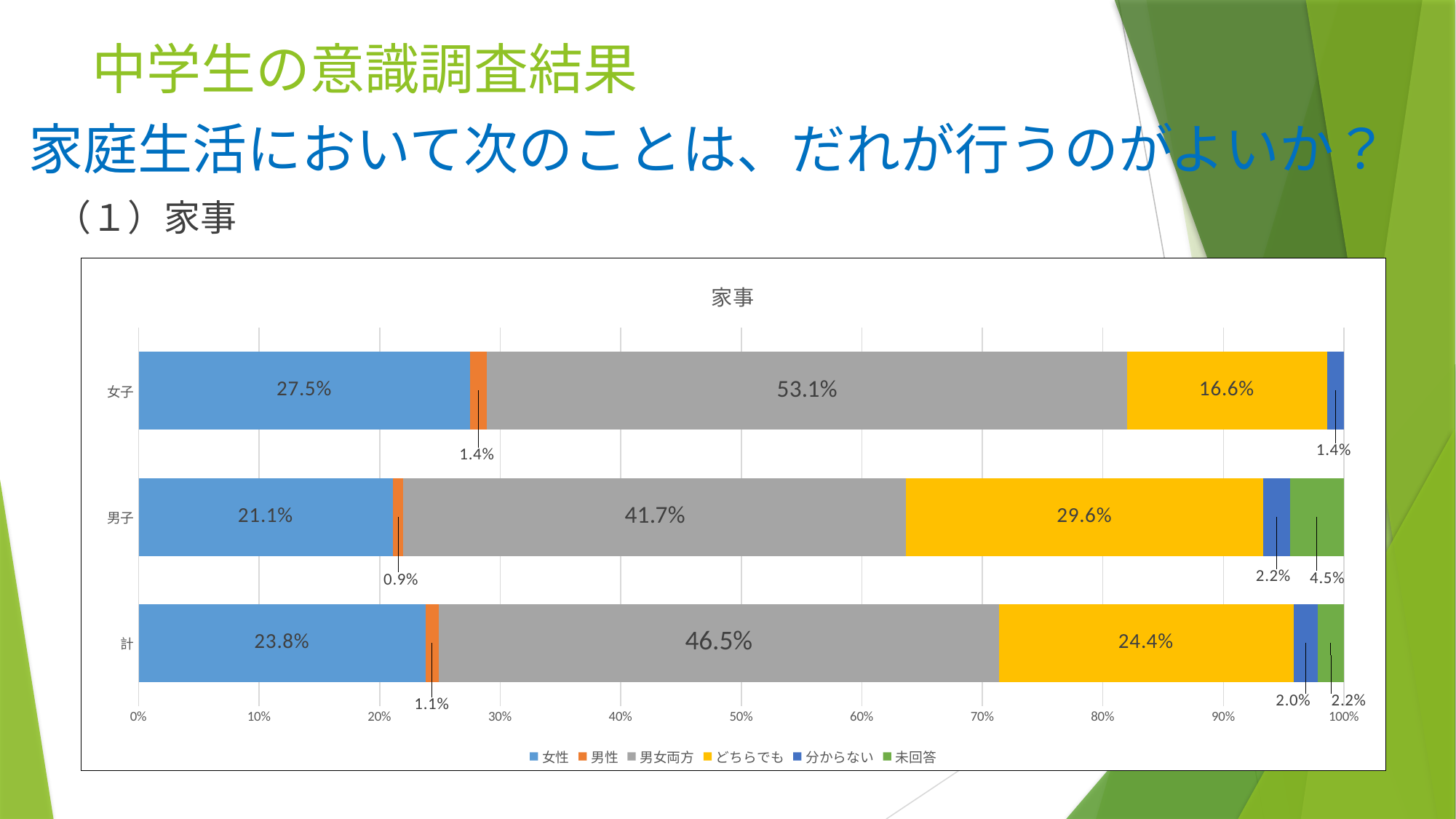
What type of chart is shown on the slide? stacked bar chart Which category has the highest 男女両方 value? 女子 How many series does the legend list? 6 What is the どちらでも value for 男子? 29.6% How many categories (bars) are shown in the chart? 3 Which is larger: the どちらでも value for 女子 or for 計? 計 What is the difference between the 女性 values for 女子 and 男子? 6.4% What is the title of the chart? 家事 What is the 未回答 value for 男子? 4.5% What is the 男女両方 value for 女子? 53.1% Which category has the lowest 男性 value? 男子 What is the 女性 value for 計? 23.8%